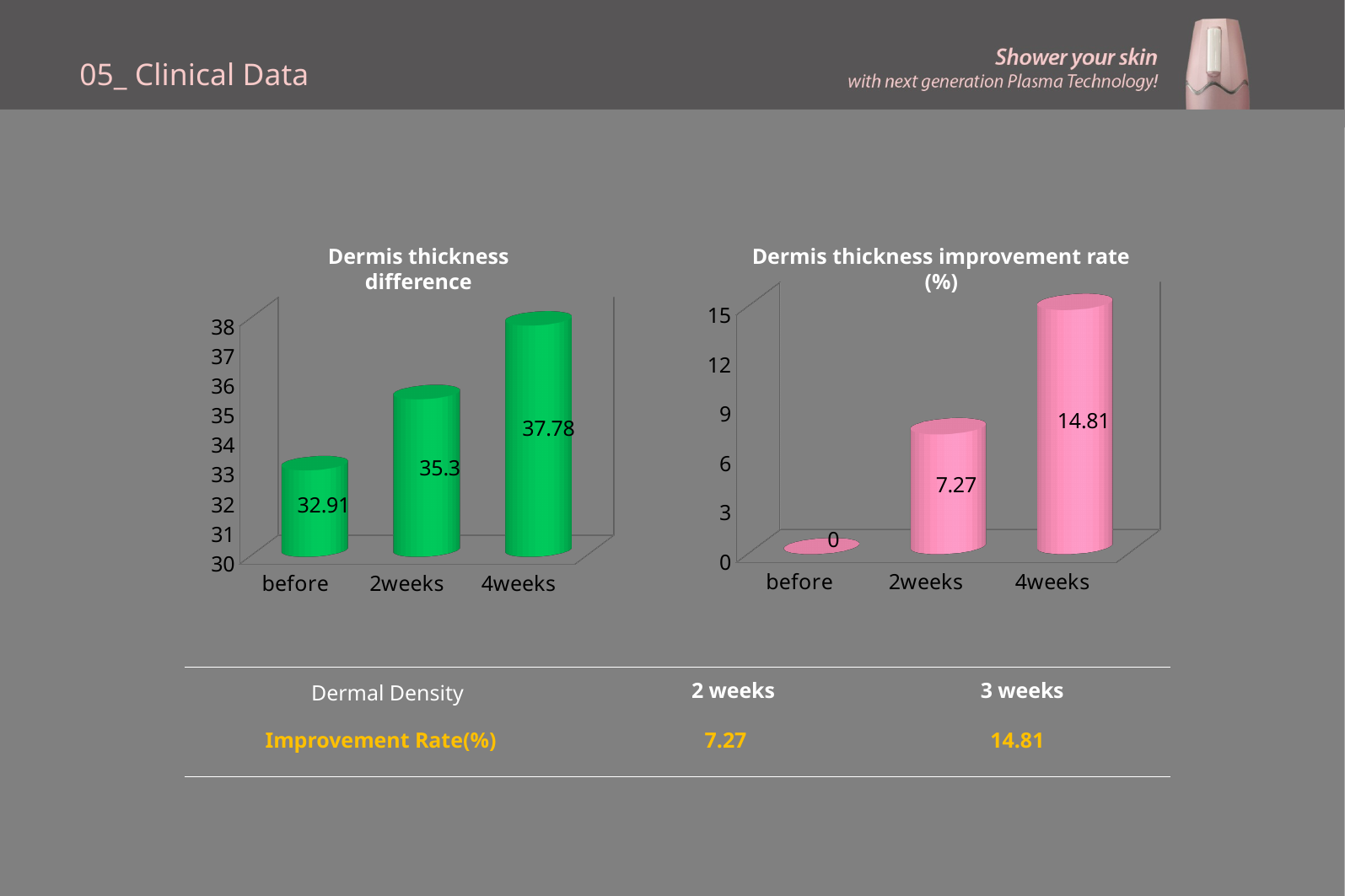
In the 'Dermis thickness improvement rate (%)' chart, what is the difference between the 4weeks and 2weeks values? 7.54 In the 'Dermis thickness difference' chart, what is the difference between the 4weeks and before values? 4.87 In the 'Dermis thickness improvement rate (%)' chart, do the values rise or fall from before to 4weeks? rise In the 'Dermis thickness difference' chart, which is larger, the value for 2weeks or the value for before? 2weeks In the 'Dermis thickness improvement rate (%)' chart, what is the value for before? 0 How many categories are shown on the x axis of the 'Dermis thickness improvement rate (%)' chart? 3 In the 'Dermis thickness difference' chart, which category has the highest value? 4weeks In the 'Dermis thickness improvement rate (%)' chart, which category has the lowest value? before In the 'Dermis thickness difference' chart, what is the value for 2weeks? 35.3 What kind of chart is the 'Dermis thickness difference' chart? bar chart In the 'Dermis thickness difference' chart, what is the value for before? 32.91 In the 'Dermis thickness improvement rate (%)' chart, what is the value for 4weeks? 14.81